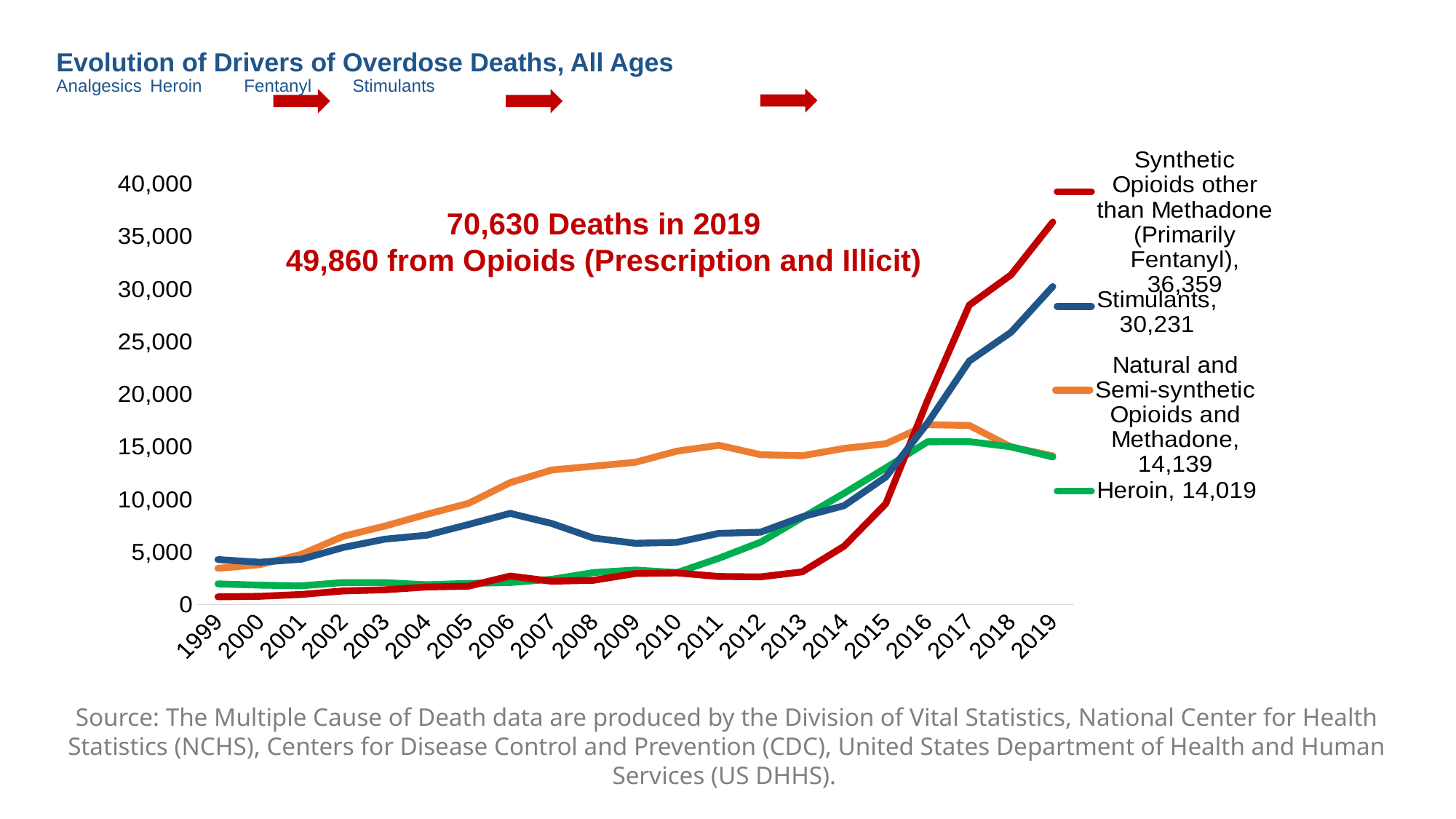
What kind of chart is shown on the slide? Line chart What is the 2019 value for Synthetic Opioids other than Methadone (Primarily Fentanyl)? 36,359 Which series has the lowest value in 2019? Heroin What is the 2019 value for Stimulants? 30,231 Is the value for Heroin in 2010 greater or less than 5,000? less Is the 2019 value for Natural and Semi-synthetic Opioids and Methadone larger or smaller than the 2019 value for Heroin? Larger Which series has the highest value in 2019? Synthetic Opioids other than Methadone (Primarily Fentanyl) What is the difference between the 2019 values for Synthetic Opioids other than Methadone and Stimulants? 6,128 Does the Synthetic Opioids other than Methadone line rise or fall from 2013 to 2019? Rise What is the 2019 value for Heroin? 14,019 How many years are shown along the x axis? 21 How many series does the legend list? 4